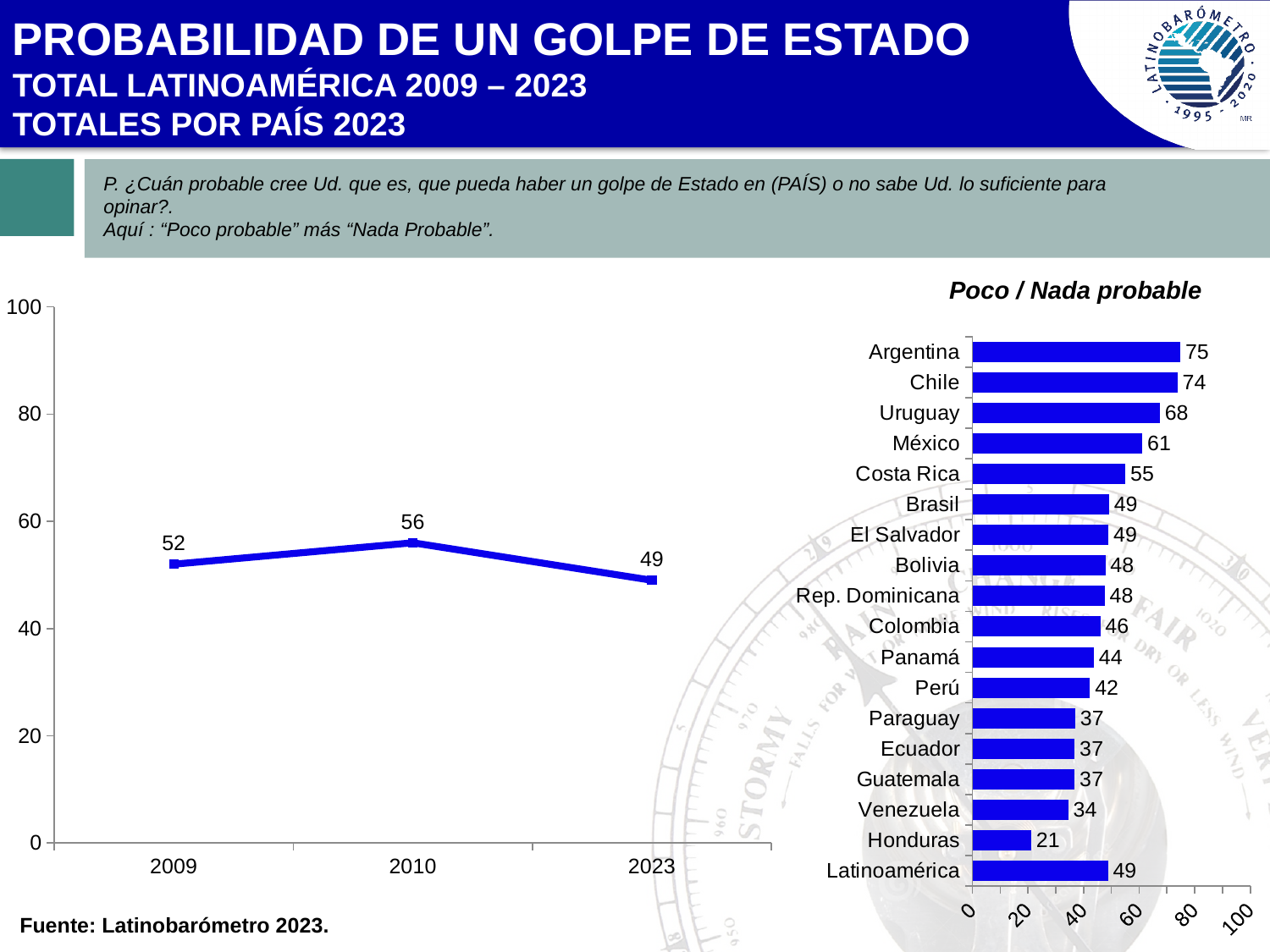
In the bar chart titled 'Poco / Nada probable', what is the difference between Argentina and Honduras? 54 In the bar chart titled 'Poco / Nada probable', which country has the lowest value? Honduras In the bar chart titled 'Poco / Nada probable', which is larger, the value for México or the value for Perú? México In the line chart on the left, which year has the highest value? 2010 In the line chart on the left, what is the difference between the 2010 value and the 2023 value? 7 What kind of chart is the one on the right titled 'Poco / Nada probable'? bar chart In the line chart on the left, does the value rise or fall from 2010 to 2023? fall In the bar chart titled 'Poco / Nada probable', what is the value for Uruguay? 68 In the line chart on the left, how many data points are plotted? 3 In the line chart on the left, what is the value for 2023? 49 In the line chart on the left, what is the value for 2010? 56 In the bar chart titled 'Poco / Nada probable', which country has the highest value? Argentina